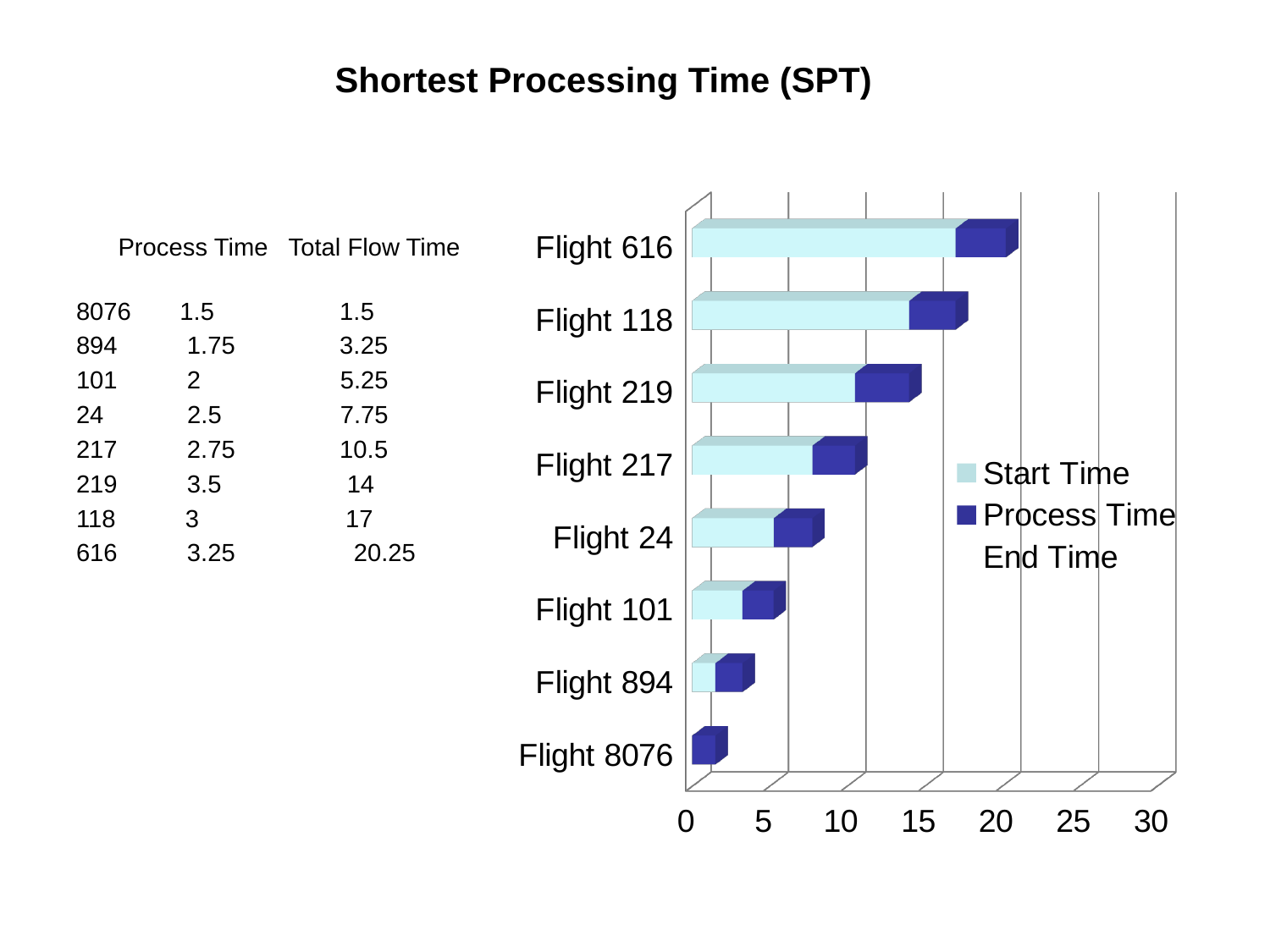
Which flight has the longest bar on the chart? Flight 616 Is the end of the bar for Flight 118 greater or less than 15? greater Going down the chart from Flight 616 to Flight 8076, do the bars get longer or shorter? shorter What is the title of the slide containing the chart? Shortest Processing Time (SPT) Which bar extends further: Flight 616 or Flight 118? Flight 616 Is the end of the bar for Flight 894 greater or less than 5? less Which flight has the shortest bar on the chart? Flight 8076 How many entries does the chart legend list? 3 Is the end of the bar for Flight 616 greater or less than 15? greater How many flights are listed as categories on the chart? 8 What kind of chart is shown on the slide? Stacked bar chart